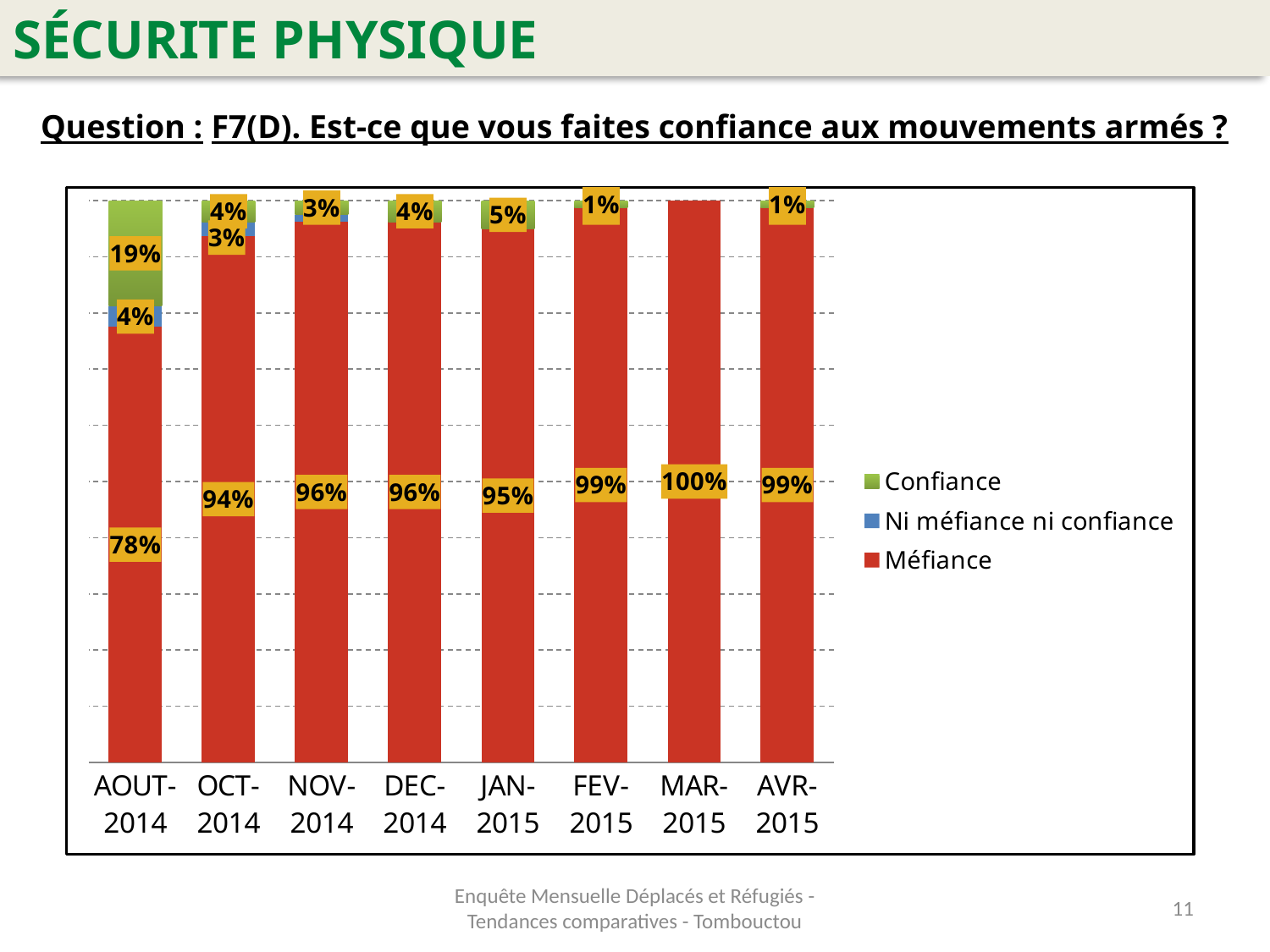
What is the Méfiance value for AOUT-2014? 78% What kind of chart is shown on the slide? Stacked bar chart What is the Méfiance value for OCT-2014? 94% How many months are shown on the x axis? 8 How many series does the legend list? 3 In which month is the Méfiance value highest? MAR-2015 Which has a larger Méfiance value, NOV-2014 or JAN-2015? NOV-2014 What is the Méfiance value for MAR-2015? 100% Does the Méfiance value generally rise or fall from AOUT-2014 to MAR-2015? Rise What is the Confiance value for AOUT-2014? 19% What is the difference between the Méfiance values for OCT-2014 and AOUT-2014? 16% In which month is the Méfiance value lowest? AOUT-2014